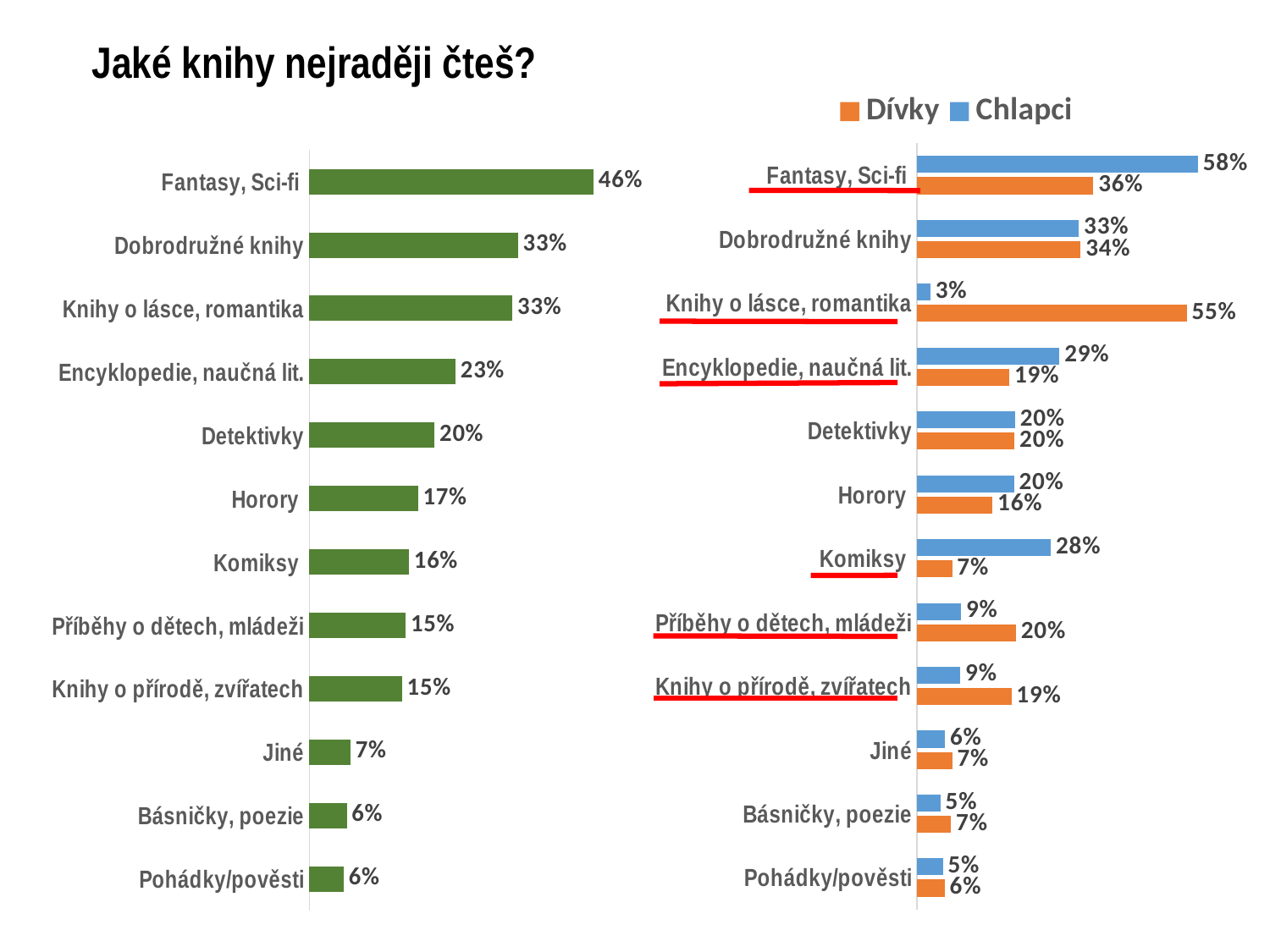
In the right chart, which category has the highest Dívky value? Knihy o lásce, romantika In the right chart, what is the difference between the Dívky and Chlapci values for Knihy o lásce, romantika? 52% In the left chart, which category has the highest value? Fantasy, Sci-fi In the right chart, what is the Dívky value for Knihy o lásce, romantika? 55% In the right chart, how many series does the legend list? 2 In the right chart, which colour represents Dívky? Orange In the right chart, what is the Chlapci value for Fantasy, Sci-fi? 58% In the left chart, how many categories are shown? 12 In the right chart, which is larger for Komiksy, Dívky or Chlapci? Chlapci What kind of chart is the left chart? Bar chart In the left chart, what is the value for Fantasy, Sci-fi? 46% In the left chart, what is the value for Detektivky? 20%